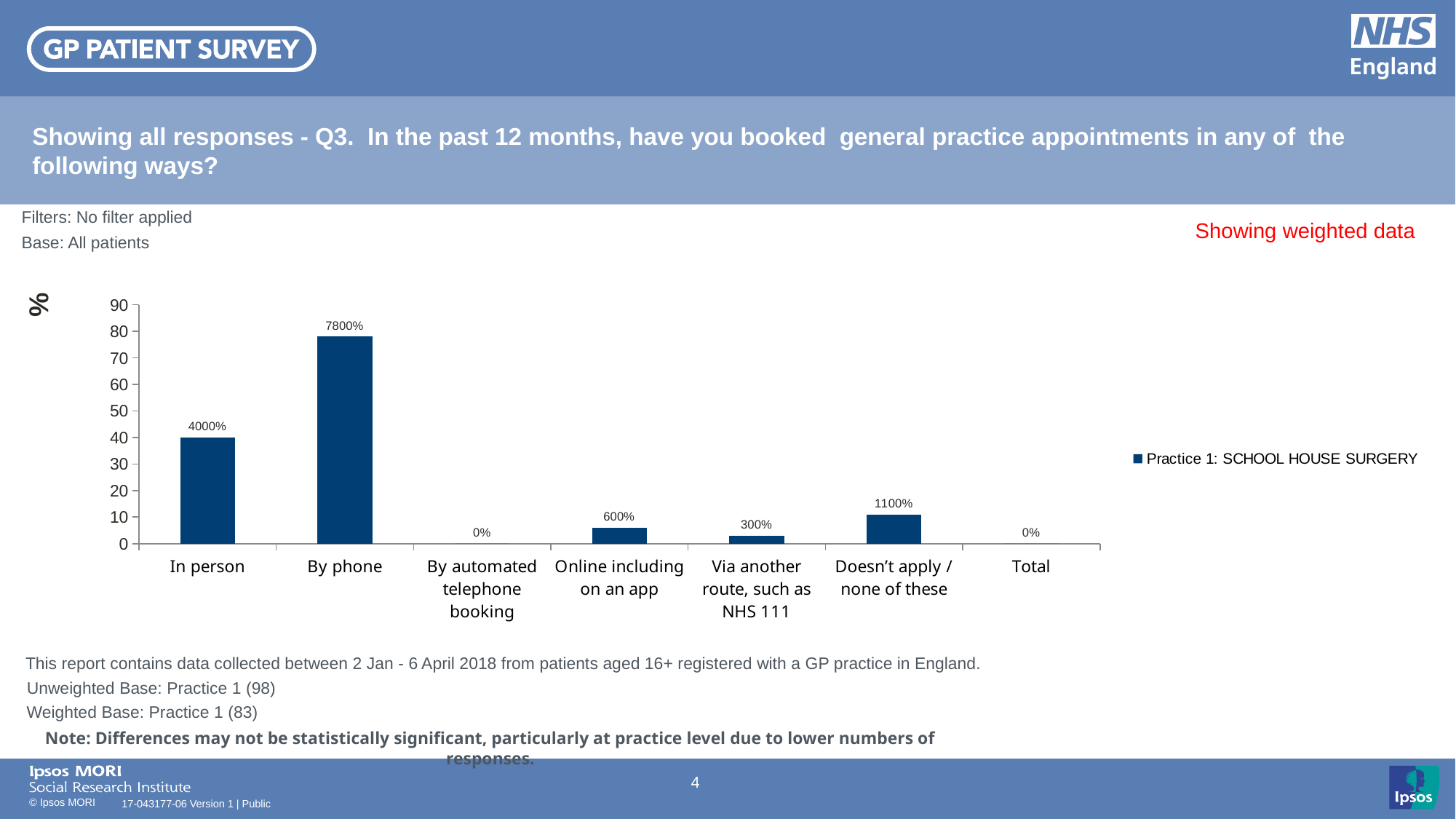
What type of chart is shown on the slide? Bar chart What is the data label shown for 'Via another route, such as NHS 111'? 300% What is the data label shown for 'Online including on an app'? 600% How many categories are shown along the x axis of the chart? 7 Is the bar for 'By phone' greater or less than 70 on the y axis? greater What is the data label shown for 'Doesn't apply / none of these'? 1100% What is the data label shown for the 'In person' bar? 4000% Which of the two bars is taller: 'In person' or 'Doesn't apply / none of these'? In person Which category has the tallest bar in the chart? By phone What is the data label shown for the 'By phone' bar? 7800% Is the bar for 'In person' greater or less than 50 on the y axis? less How many series does the legend list? 1